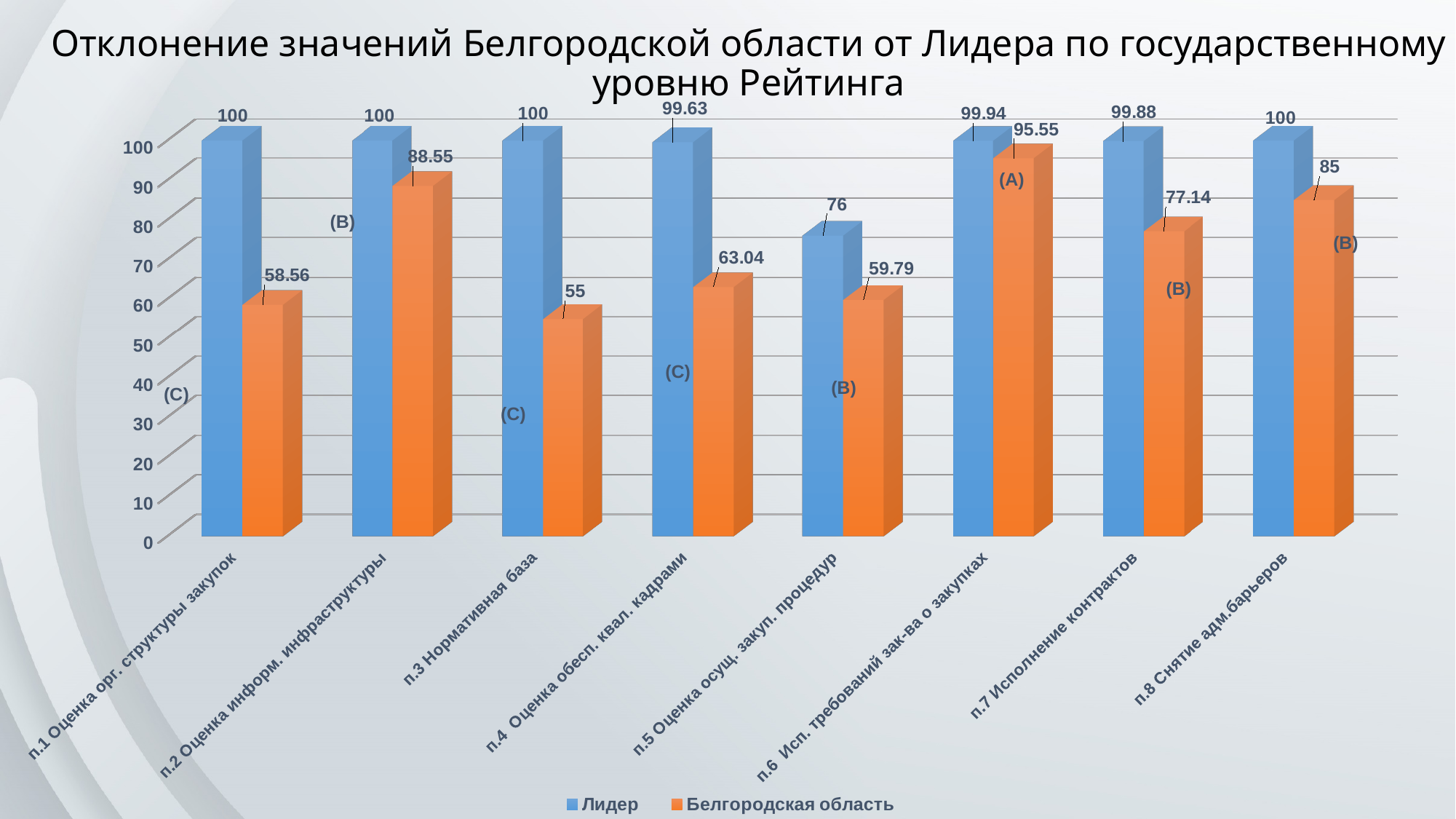
How many categories are shown on the x axis? 8 Which category has the lowest value for Лидер? п.5 Оценка осущ. закуп. процедур What is the value for Лидер for п.5 Оценка осущ. закуп. процедур? 76 What is the value for Белгородская область for п.7 Исполнение контрактов? 77.14 Which category has the lowest value for Белгородская область? п.3 Нормативная база What is the difference between Лидер and Белгородская область for п.4 Оценка обесп. квал. кадрами? 36.59 Which category has the highest value for Белгородская область? п.6 Исп. требований зак-ва о закупках What colour are the bars for the Белгородская область series? Orange How many series does the legend list? 2 What kind of chart is shown on the slide? Bar chart Which is larger: the Белгородская область value for п.2 Оценка информ. инфраструктуры or for п.8 Снятие адм.барьеров? п.2 Оценка информ. инфраструктуры What is the value for Белгородская область for п.1 Оценка орг. структуры закупок? 58.56